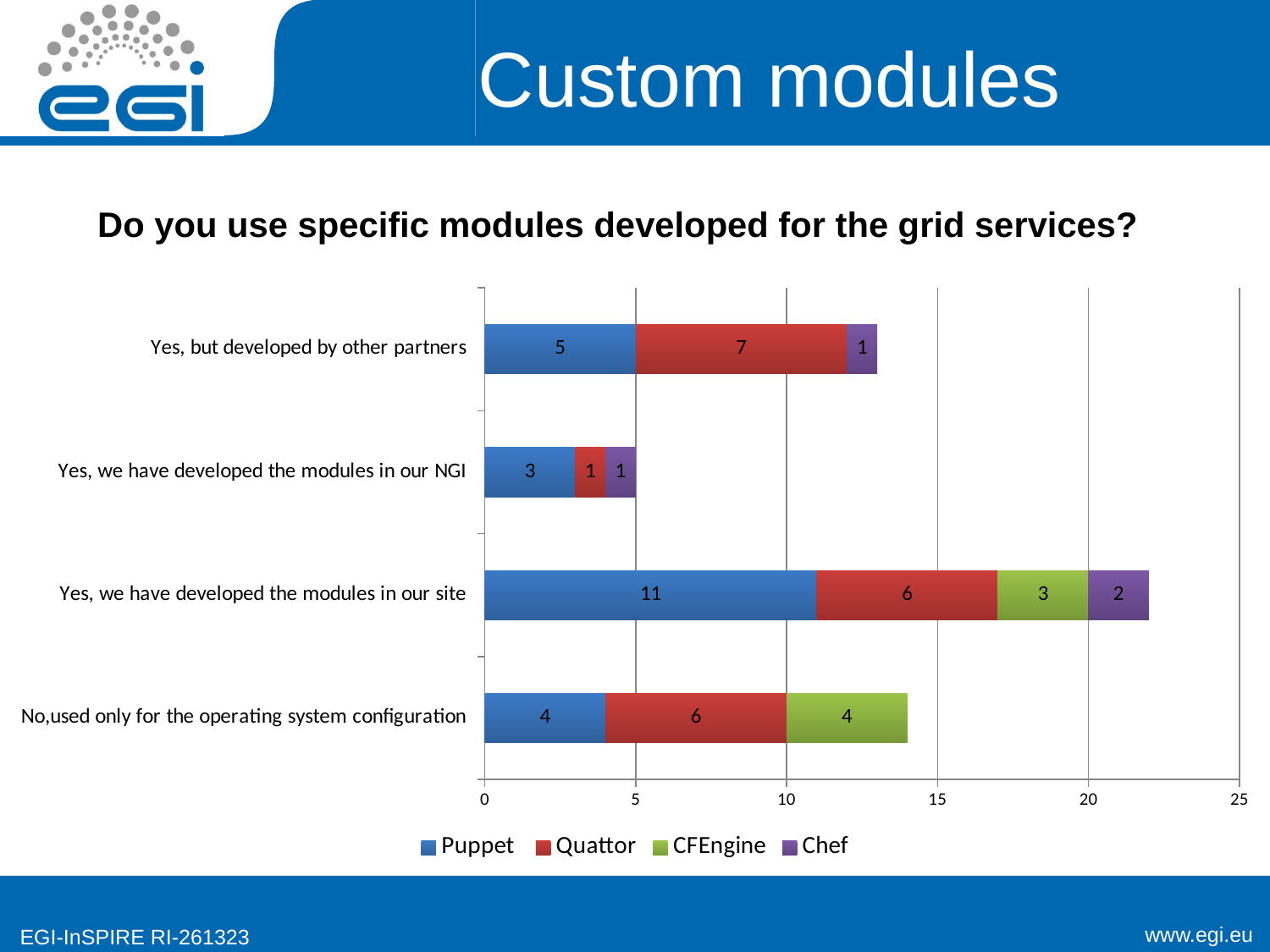
Which category has the highest Puppet value? Yes, we have developed the modules in our site Which is larger: the Quattor value for "Yes, but developed by other partners" or the Quattor value for "No,used only for the operating system configuration"? Yes, but developed by other partners What kind of chart is shown on the slide? Stacked bar chart What is the difference between the Puppet values for "Yes, we have developed the modules in our site" and "Yes, but developed by other partners"? 6 What is the total of the stacked bar for "Yes, we have developed the modules in our NGI"? 5 How many series does the legend list? 4 What is the Chef value for "Yes, we have developed the modules in our site"? 2 What is the Quattor value for "Yes, but developed by other partners"? 7 Which category has the lowest Quattor value? Yes, we have developed the modules in our NGI What is the total of the stacked bar for "Yes, we have developed the modules in our site"? 22 What is the CFEngine value for "No,used only for the operating system configuration"? 4 What is the Puppet value for "Yes, we have developed the modules in our site"? 11